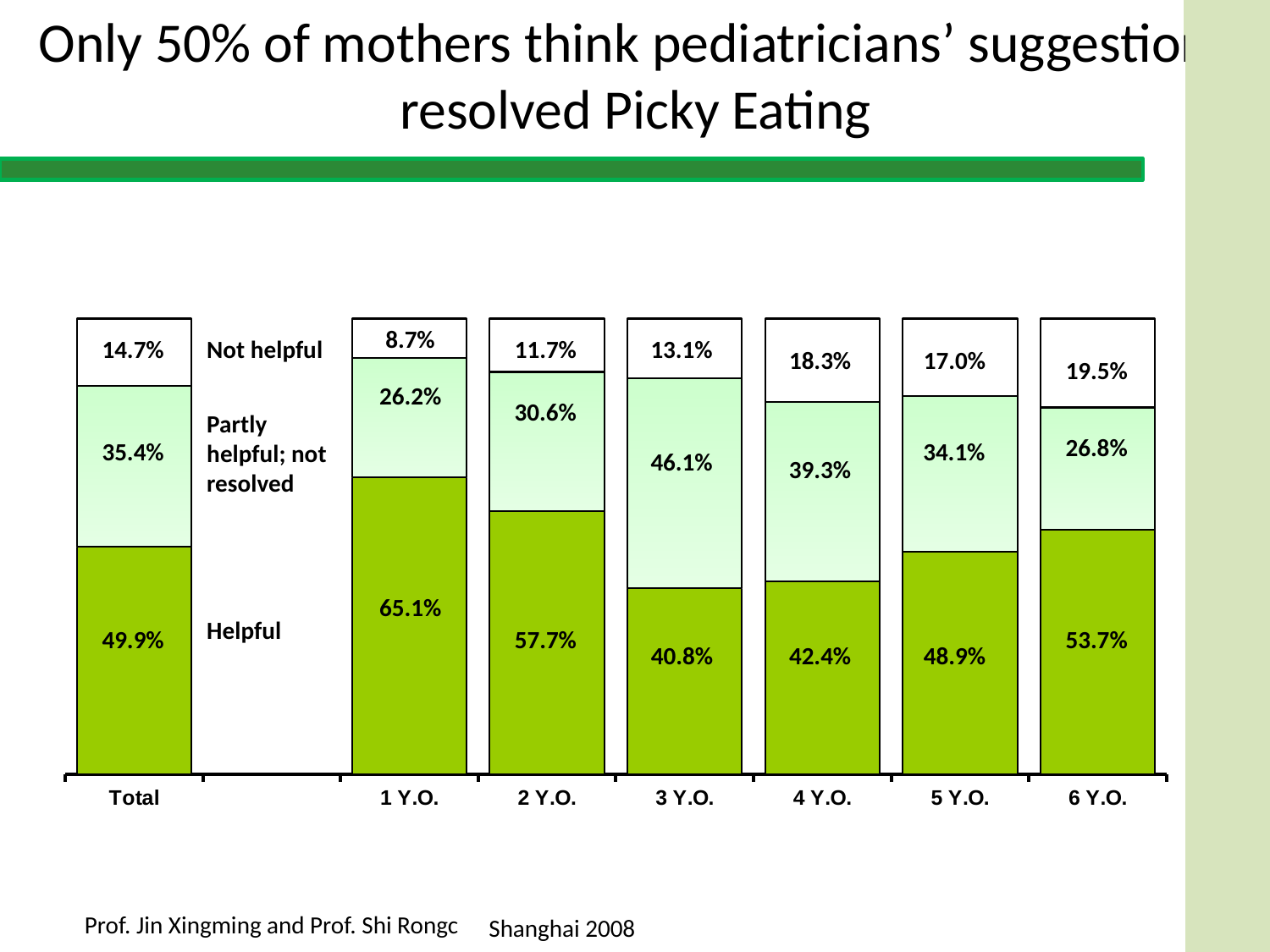
What is the Not helpful percentage for the 4 Y.O. group? 18.3% Which group has the highest Not helpful percentage? 6 Y.O. What is the 'Partly helpful; not resolved' percentage for the 3 Y.O. group? 46.1% Which age group has the lowest Helpful percentage? 3 Y.O. What kind of chart is shown on the slide? Stacked bar chart What percentage of mothers in the Total group found the pediatricians' suggestions Helpful? 49.9% Which age group has the highest Helpful percentage? 1 Y.O. Which is larger, the Helpful percentage for 2 Y.O. or for 6 Y.O.? 2 Y.O. How many groups (bars) are shown on the x axis? 7 How many response categories are stacked in each bar? 3 What is the difference in Helpful percentage between the 1 Y.O. and 3 Y.O. groups? 24.3 percentage points Does the Not helpful percentage rise or fall from 1 Y.O. to 4 Y.O.? Rise